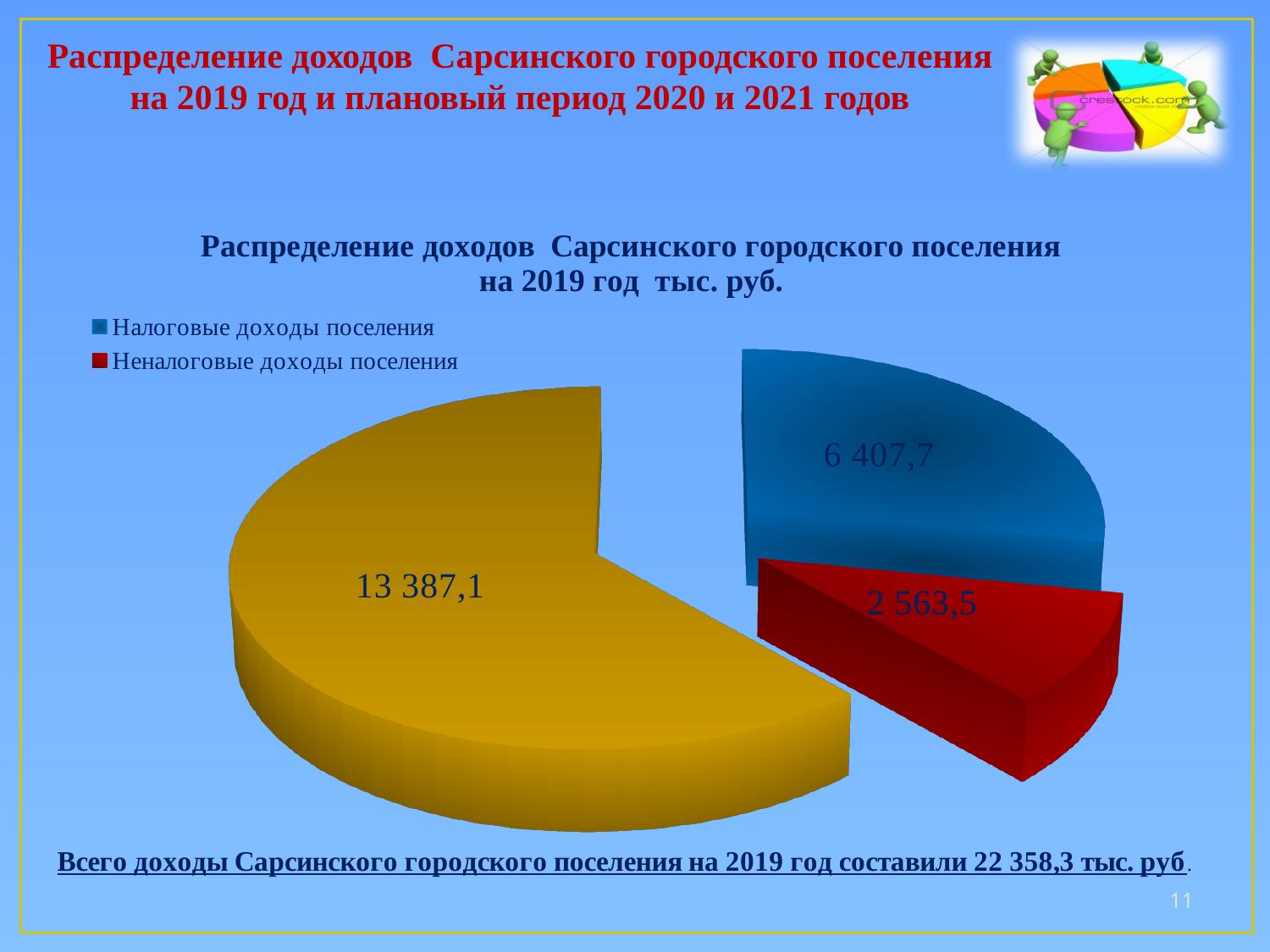
How many slices does the pie chart have? 3 Which is larger: Налоговые доходы поселения or Неналоговые доходы поселения? Налоговые доходы поселения According to the slide, what is the total income of Сарсинское городское поселение for 2019? 22 358,3 тыс. руб. What value is printed on the yellow slice of the pie chart? 13 387,1 What colour is the slice for Неналоговые доходы поселения? red What is the value for Неналоговые доходы поселения in the pie chart? 2 563,5 What is the difference between Налоговые доходы поселения and Неналоговые доходы поселения? 3 844,2 How many entries does the chart legend list? 2 What is the value for Налоговые доходы поселения in the pie chart? 6 407,7 Which of the two legend categories, Налоговые доходы поселения or Неналоговые доходы поселения, has the smaller value? Неналоговые доходы поселения What is the largest value shown on the pie chart? 13 387,1 What type of chart is shown on the slide? pie chart